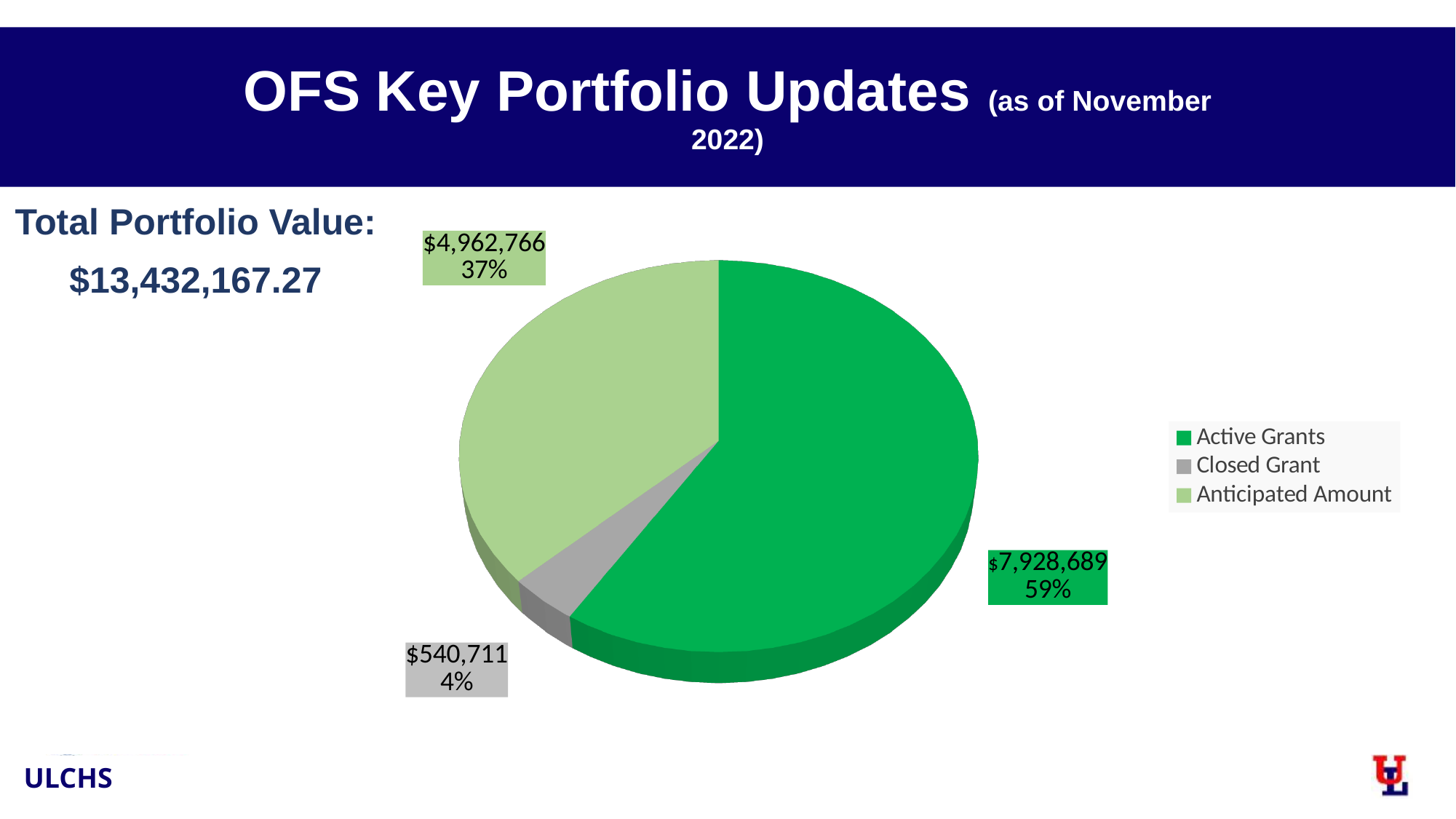
What share of the pie does Anticipated Amount represent? 37% What is the value of the Anticipated Amount slice? $4,962,766 What share of the pie does Active Grants represent? 59% Which category has the largest slice of the pie? Active Grants What is the value of the Active Grants slice? $7,928,689 Which is larger, Anticipated Amount or Closed Grant? Anticipated Amount Which category has the smallest slice of the pie? Closed Grant What share of the pie does Closed Grant represent? 4% How many categories does the legend list? 3 What is the difference between the Active Grants value and the Anticipated Amount value? $2,965,923 What kind of chart is shown on the slide? Pie chart What is the value of the Closed Grant slice? $540,711